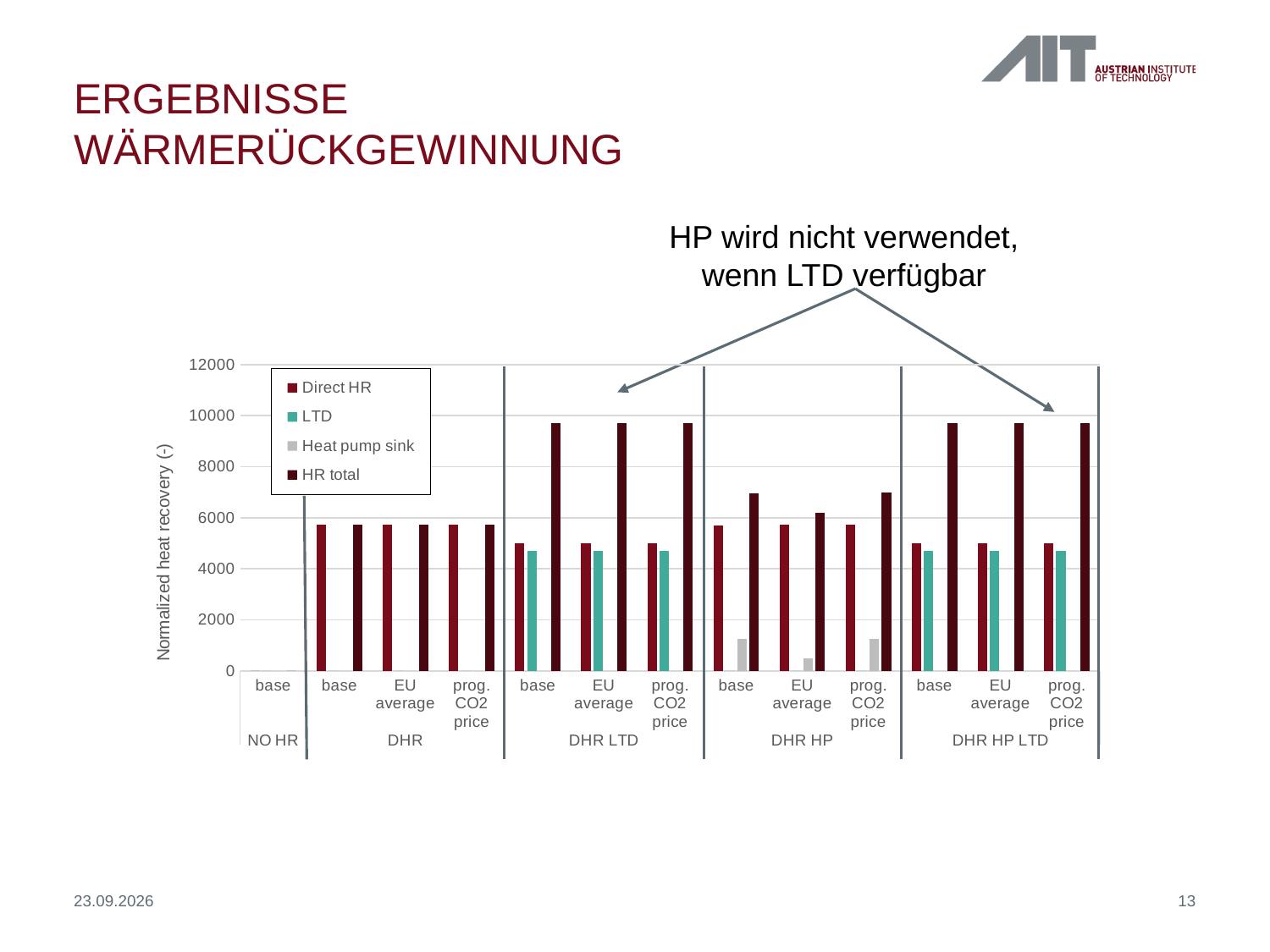
Is the HR total value for the DHR LTD base scenario greater or less than 8000? greater How many series does the chart legend list? 4 How many scenario groups (NO HR, DHR, etc.) are shown along the x axis? 5 Is the Heat pump sink value for the DHR HP EU average scenario greater or less than 2000? less Is the LTD value for the DHR HP LTD base scenario greater or less than 6000? less Which is larger: the Direct HR value for DHR base or the Direct HR value for DHR LTD base? DHR base What kind of chart is shown on the slide? bar chart Which series is drawn in teal/green in the legend? LTD Within the DHR HP group, which scenario has the lowest Heat pump sink value? EU average Which is larger: the HR total for DHR LTD base or the HR total for DHR HP base? DHR LTD base What is the label of the y axis? Normalized heat recovery (-)